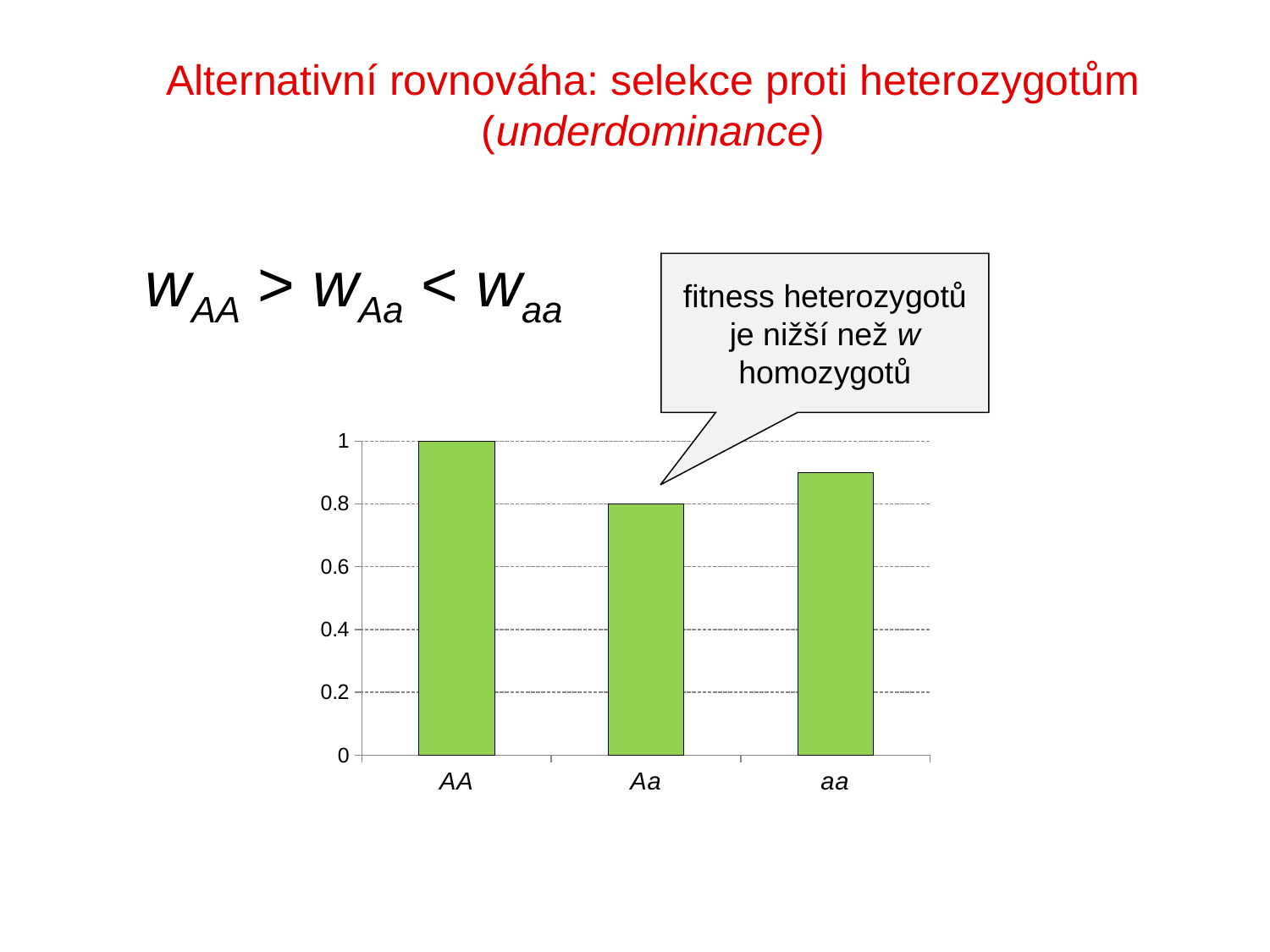
What colour are the bars in the chart? green How many categories are shown on the x axis? 3 Which category has the lowest value? Aa What kind of chart is shown on the slide? bar chart Is the value for aa greater or less than 1? less What is the difference between the values for AA and Aa? 0.2 Which is larger, the value for AA or the value for aa? AA What is the value for AA? 1 Is the value for aa greater or less than 0.8? greater Which category has the highest value? AA